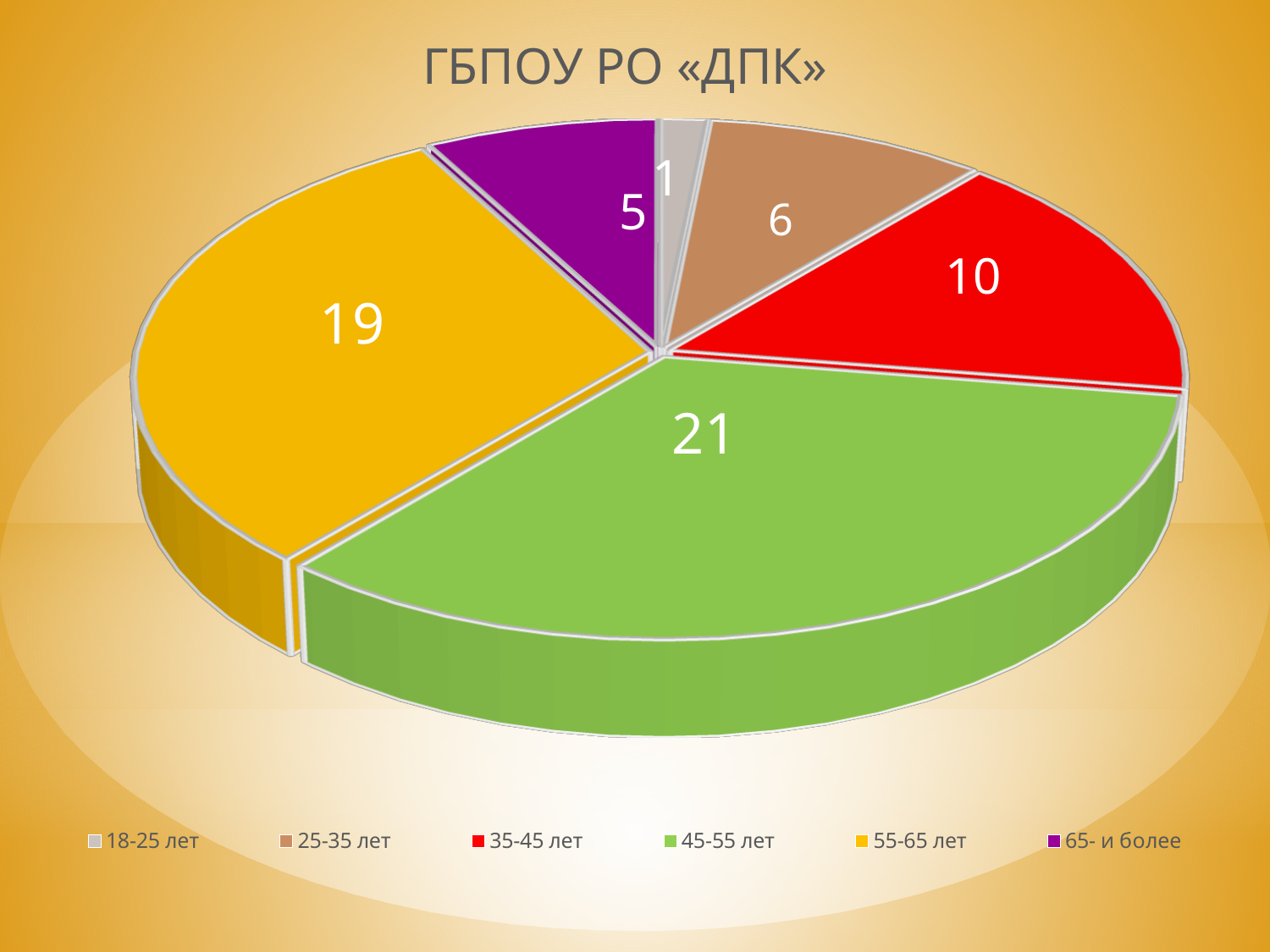
What is the difference between the values for 35-45 лет and 25-35 лет? 4 Which age group has the largest slice? 45-55 лет How many categories does the pie chart have? 6 What is the value for the 65- и более slice? 5 What type of chart is shown on the slide? Pie chart What is the difference between the values for 45-55 лет and 55-65 лет? 2 Which age group has the smallest slice? 18-25 лет What is the value for the 55-65 лет slice? 19 What is the title of the chart? ГБПОУ РО «ДПК» What is the value for the 35-45 лет slice? 10 What is the value for the 45-55 лет slice? 21 Which is larger, the value for 25-35 лет or the value for 65- и более? 25-35 лет